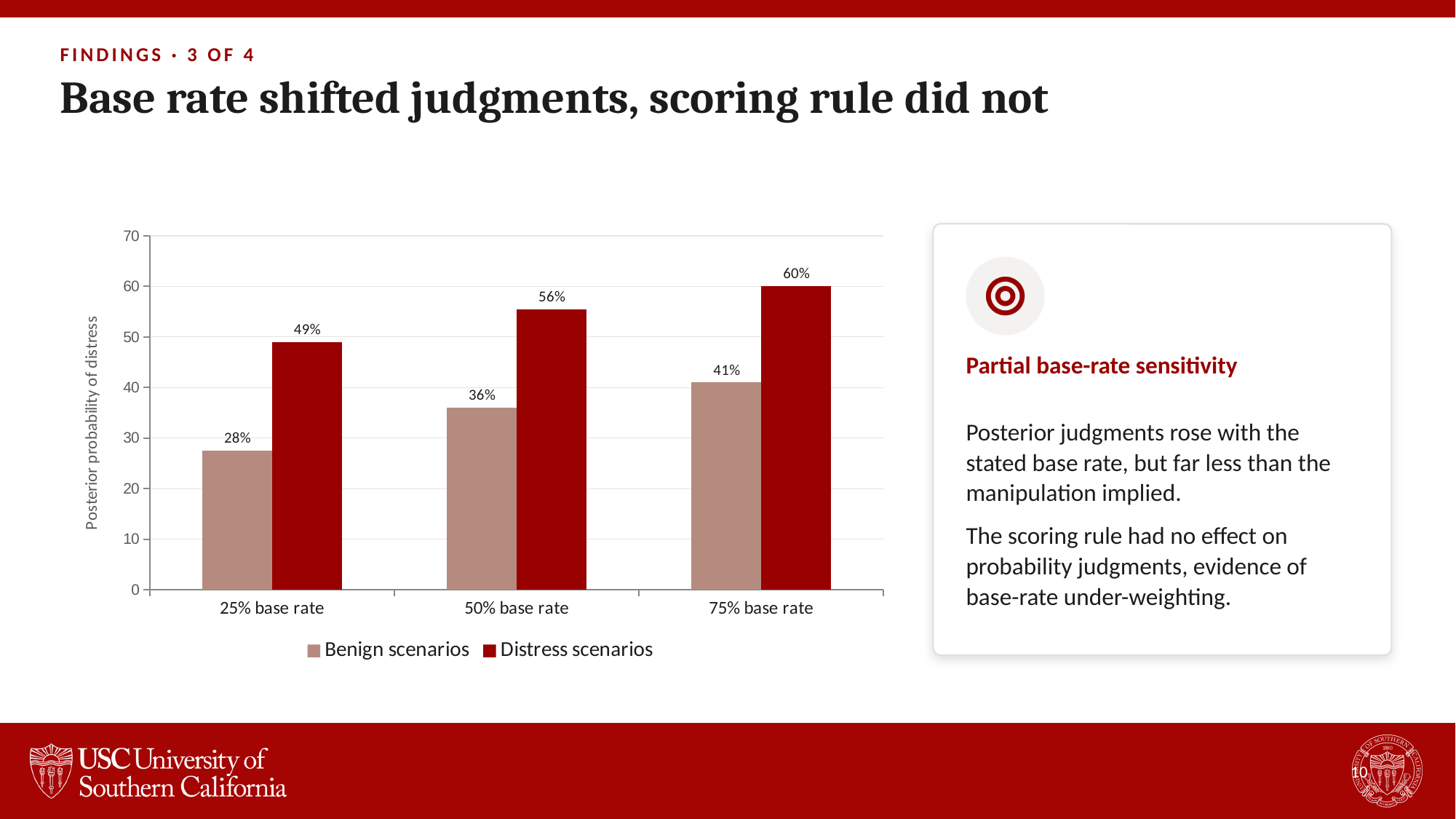
Which is larger: Benign scenarios at the 75% base rate or Distress scenarios at the 25% base rate? Distress scenarios at the 25% base rate What kind of chart is shown on the slide? Bar chart What is the value for Benign scenarios at the 75% base rate? 41% How many base rate categories are shown on the x axis? 3 Which base rate has the highest value for Distress scenarios? 75% base rate Do the Benign scenarios values rise or fall as the base rate increases along the x axis? Rise What is the difference between the Distress scenarios values at the 75% base rate and the 25% base rate? 11 percentage points What is the difference between the Distress scenarios and Benign scenarios values at the 25% base rate? 21 percentage points What is the value for Distress scenarios at the 25% base rate? 49% What is the value for Benign scenarios at the 50% base rate? 36% Which base rate has the lowest value for Benign scenarios? 25% base rate How many series does the legend list? 2